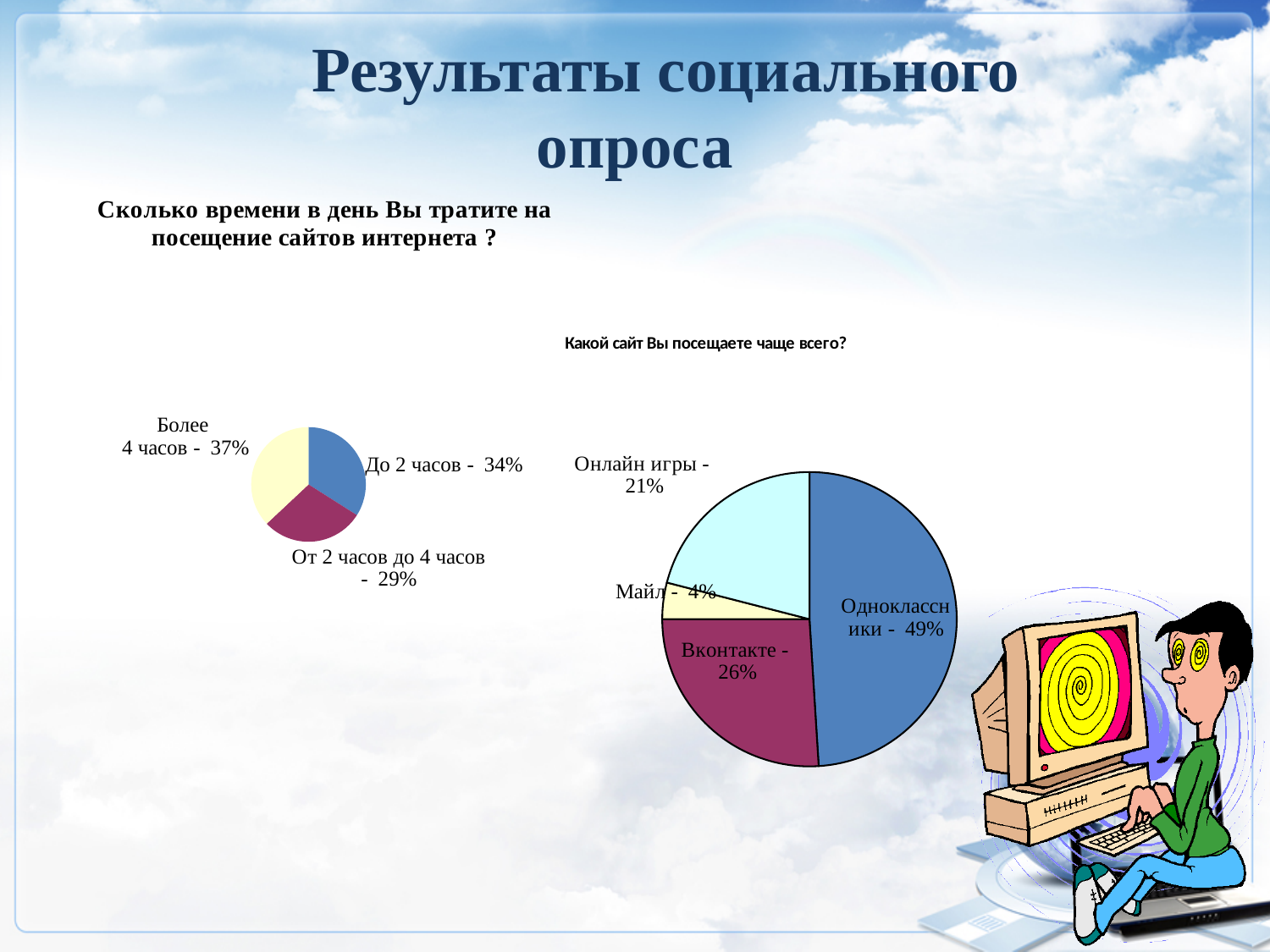
In the left pie chart (time spent per day on internet sites), what share is labelled for 'До 2 часов'? 34% In the right pie chart 'Какой сайт Вы посещаете чаще всего?', which site has the smallest share? Майл In the left pie chart (time spent per day on internet sites), what is the difference between the shares for 'Более 4 часов' and 'От 2 часов до 4 часов'? 8% In the left pie chart (time spent per day on internet sites), which category has the smallest share? От 2 часов до 4 часов In the right pie chart 'Какой сайт Вы посещаете чаще всего?', which is larger: the share for 'Вконтакте' or for 'Онлайн игры'? Вконтакте In the right pie chart 'Какой сайт Вы посещаете чаще всего?', what is the difference between the shares for 'Одноклассники' and 'Вконтакте'? 23% In the right pie chart 'Какой сайт Вы посещаете чаще всего?', what share is labelled for 'Одноклассники'? 49% In the left pie chart (time spent per day on internet sites), how many slices does the pie have? 3 In the right pie chart 'Какой сайт Вы посещаете чаще всего?', which site has the largest share? Одноклассники What type of chart is used for both charts on the slide? Pie chart In the left pie chart (time spent per day on internet sites), what share is labelled for 'Более 4 часов'? 37% In the right pie chart 'Какой сайт Вы посещаете чаще всего?', what share is labelled for 'Онлайн игры'? 21%